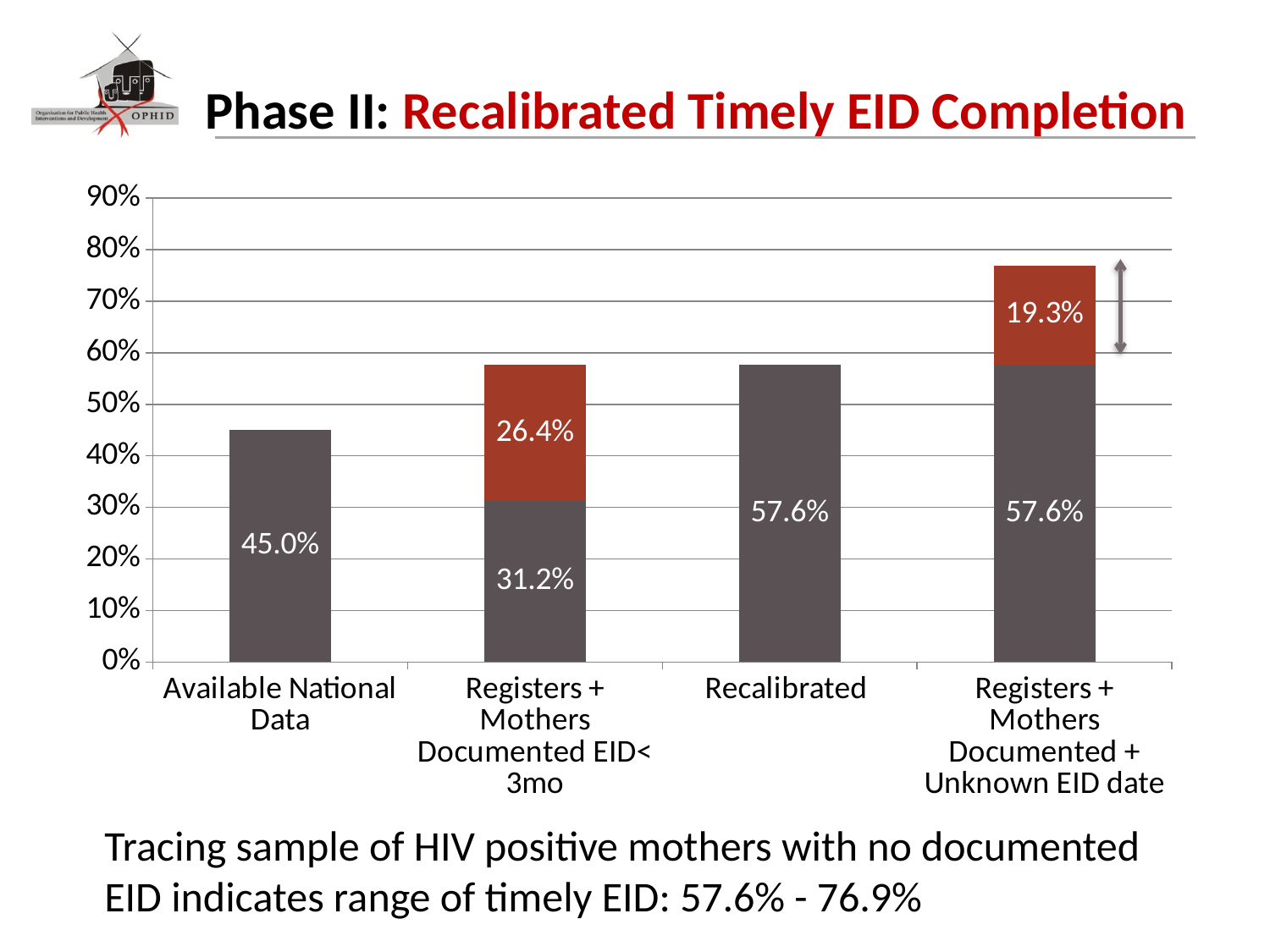
How many categories are shown on the x axis? 4 What is the value of the upper (red) segment of the Registers + Mothers Documented + Unknown EID date bar? 19.3% What is the value for Available National Data? 45.0% What is the value for Recalibrated? 57.6% Which category has the tallest bar overall? Registers + Mothers Documented + Unknown EID date What is the value of the lower (dark) segment of the Registers + Mothers Documented EID< 3mo bar? 31.2% What is the difference between the Recalibrated value and the Available National Data value? 12.6% What kind of chart is shown on the slide? Stacked bar chart Which category has the shortest bar? Available National Data What is the total of the stacked bar for Registers + Mothers Documented + Unknown EID date? 76.9% What is the total of the stacked bar for Registers + Mothers Documented EID< 3mo? 57.6% Which is larger: the upper segment of the Registers + Mothers Documented EID< 3mo bar or the upper segment of the Registers + Mothers Documented + Unknown EID date bar? Registers + Mothers Documented EID< 3mo